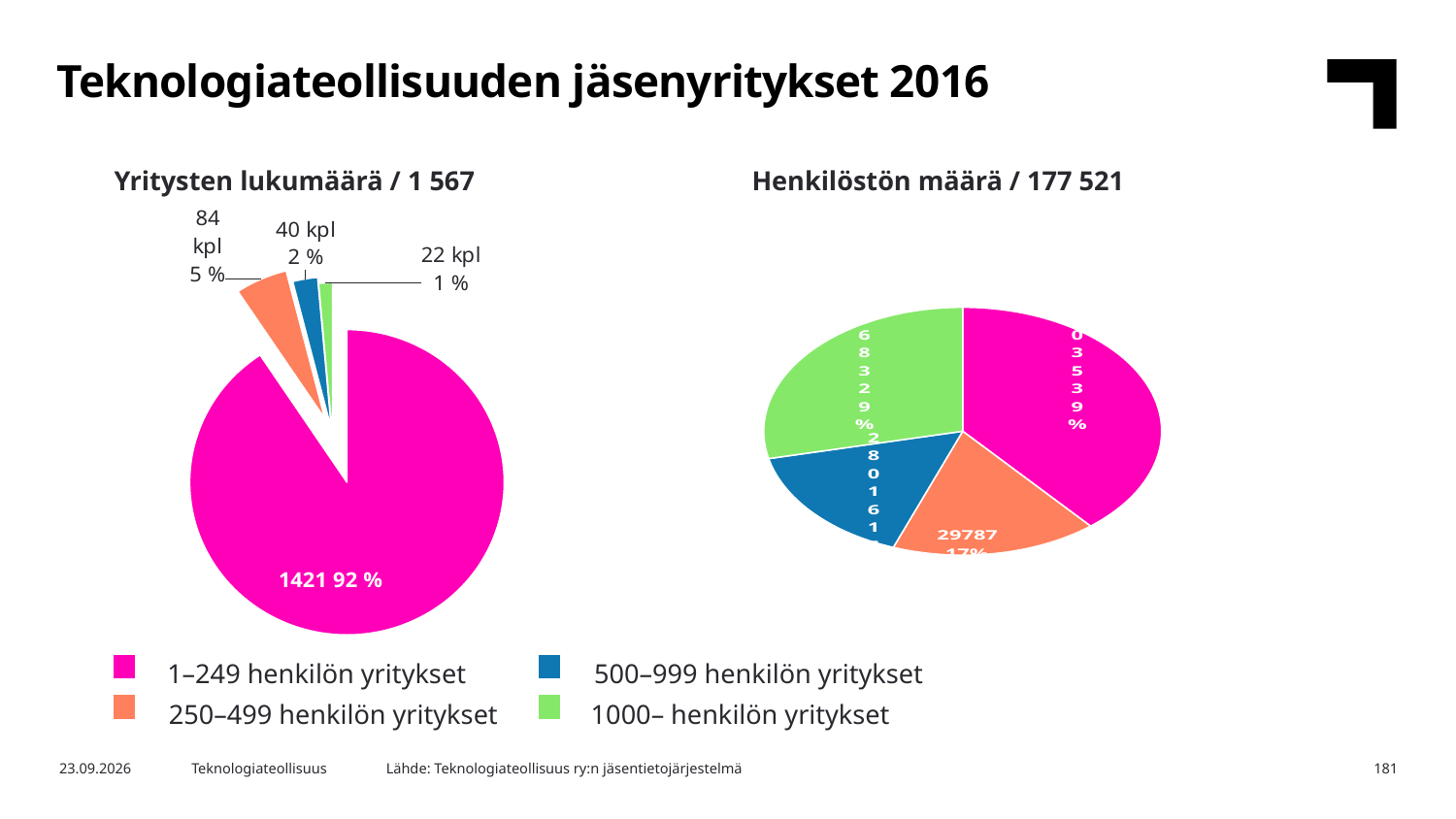
In the right pie chart (Henkilöstön määrä), which category has the largest slice? 1–249 henkilön yritykset In the left pie chart (Yritysten lukumäärä), what is the difference in company count between the 250–499 and 500–999 categories? 44 In the left pie chart (Yritysten lukumäärä), how many companies are in the 1000– henkilön yritykset category? 22 kpl In the left pie chart (Yritysten lukumäärä), what share do 500–999 henkilön yritykset represent? 2 % In the left pie chart (Yritysten lukumäärä), what share of companies do 1–249 henkilön yritykset represent? 92 % In the right pie chart (Henkilöstön määrä), which slice is larger: 1000– henkilön yritykset or 250–499 henkilön yritykset? 1000– henkilön yritykset In the left pie chart (Yritysten lukumäärä), which category has the largest slice? 1–249 henkilön yritykset In the left pie chart (Yritysten lukumäärä), how many companies are in the 250–499 henkilön yritykset category? 84 kpl How many categories does the legend list? 4 What type of chart is used on this slide? Pie chart In the left pie chart (Yritysten lukumäärä), how many companies are in the 1–249 henkilön yritykset category? 1421 In the left pie chart (Yritysten lukumäärä), which category has the smallest slice? 1000– henkilön yritykset